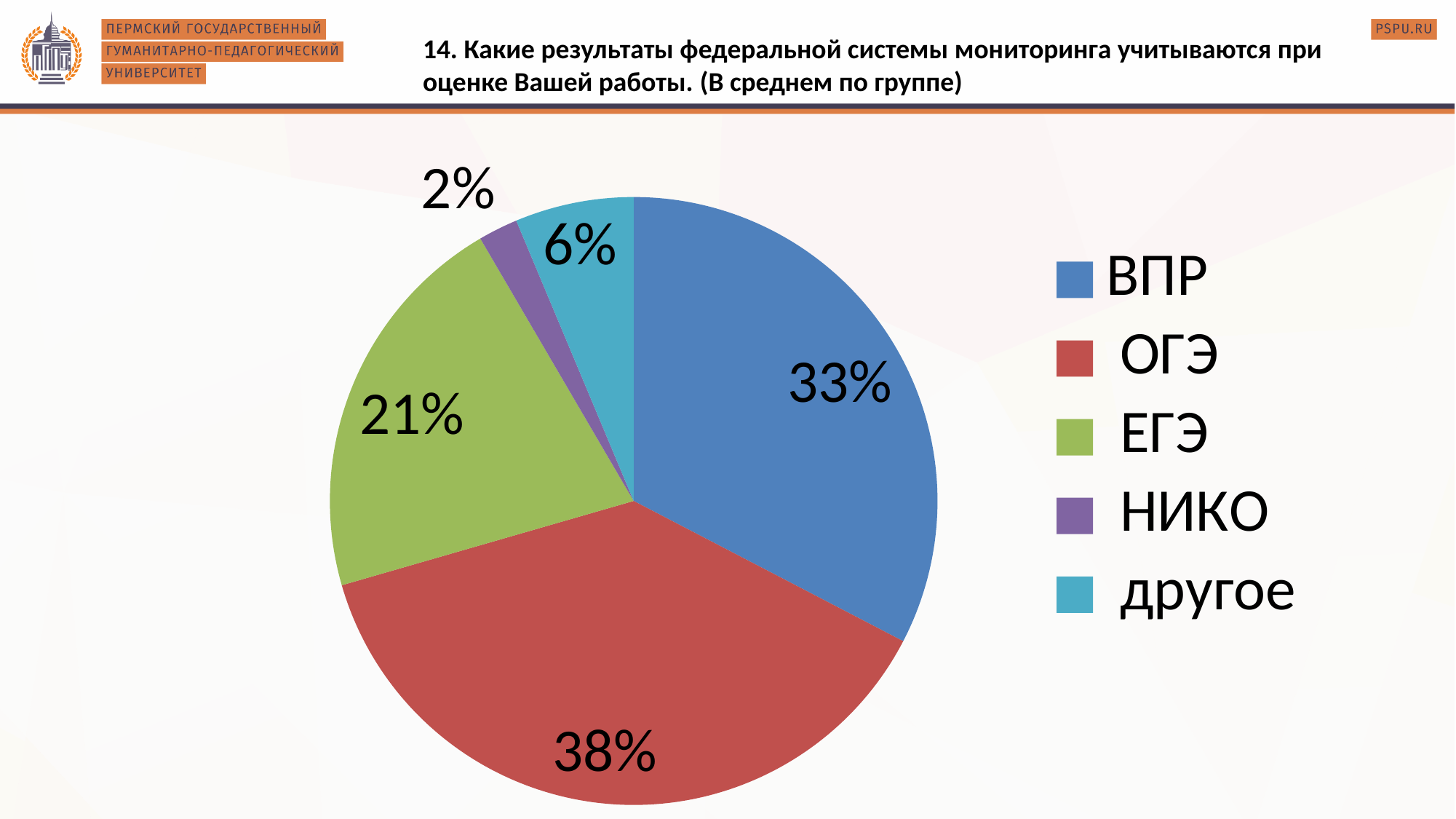
How many slices does the pie chart have? 5 What type of chart is shown on the slide? pie chart Which slice is larger, ЕГЭ or другое? ЕГЭ What percentage of the pie chart is labelled for ЕГЭ? 21% What percentage of the pie chart is labelled for другое? 6% What percentage of the pie chart is labelled for ВПР? 33% Which category has the largest slice of the pie chart? ОГЭ What percentage of the pie chart is labelled for ОГЭ? 38% What colour is the slice for ЕГЭ in the pie chart? green What is the difference in percentage points between the ОГЭ slice and the ВПР slice? 5 What percentage of the pie chart is labelled for НИКО? 2% Which category has the smallest slice of the pie chart? НИКО